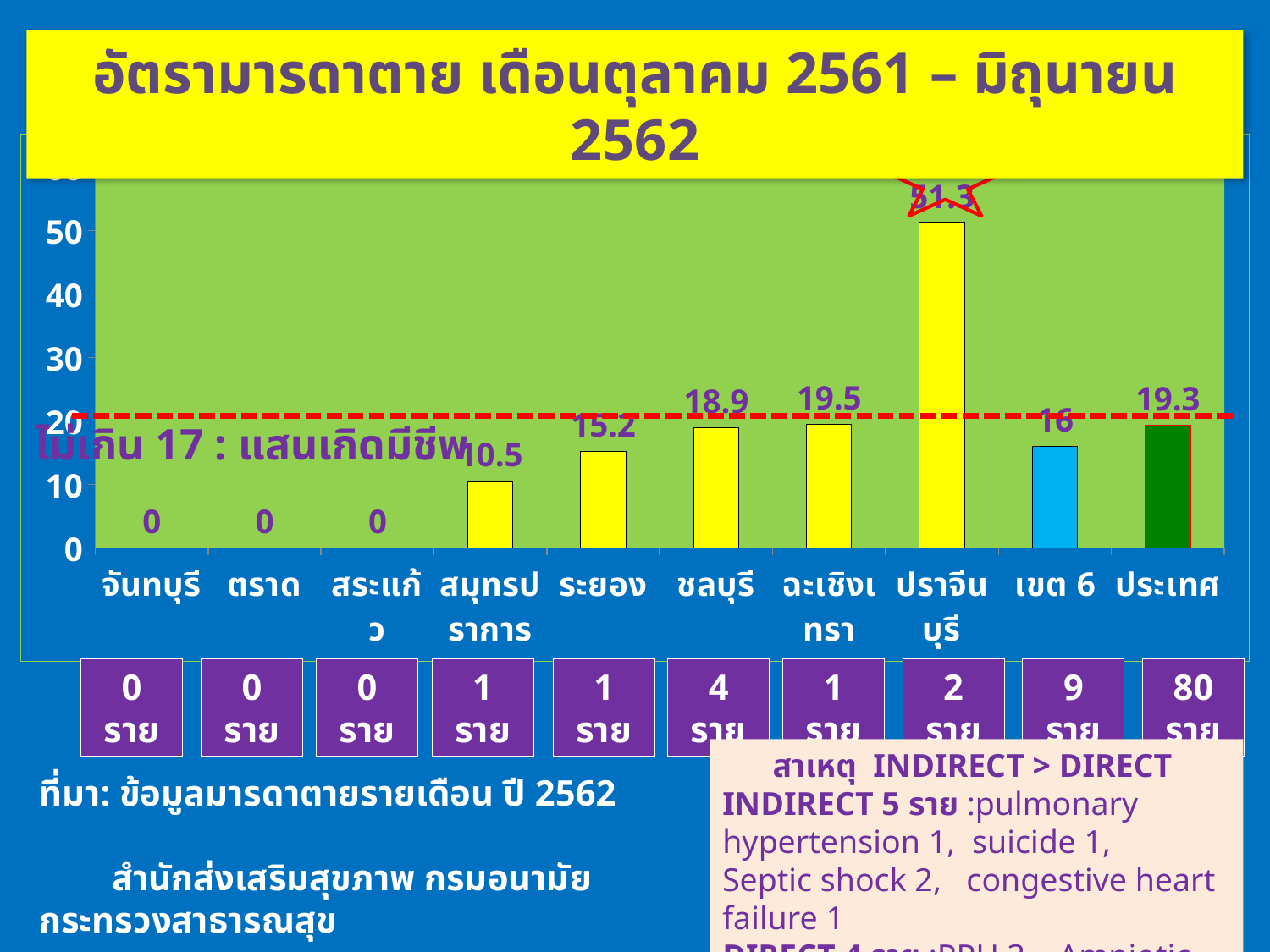
How many categories have a value of 0? 3 What is the value for ฉะเชิงเทรา? 19.5 How many categories are shown on the x axis? 10 What is the value for ชลบุรี? 18.9 What type of chart is shown on the slide? bar chart Is the value for ปราจีนบุรี greater or less than 50? greater Which is larger, the value for ระยอง or the value for สมุทรปราการ? ระยอง Which category has the highest value? ปราจีนบุรี What is the difference between the values for ฉะเชิงเทรา and ชลบุรี? 0.6 What is the value for สมุทรปราการ? 10.5 What is the value for จันทบุรี? 0 What is the value for ประเทศ? 19.3